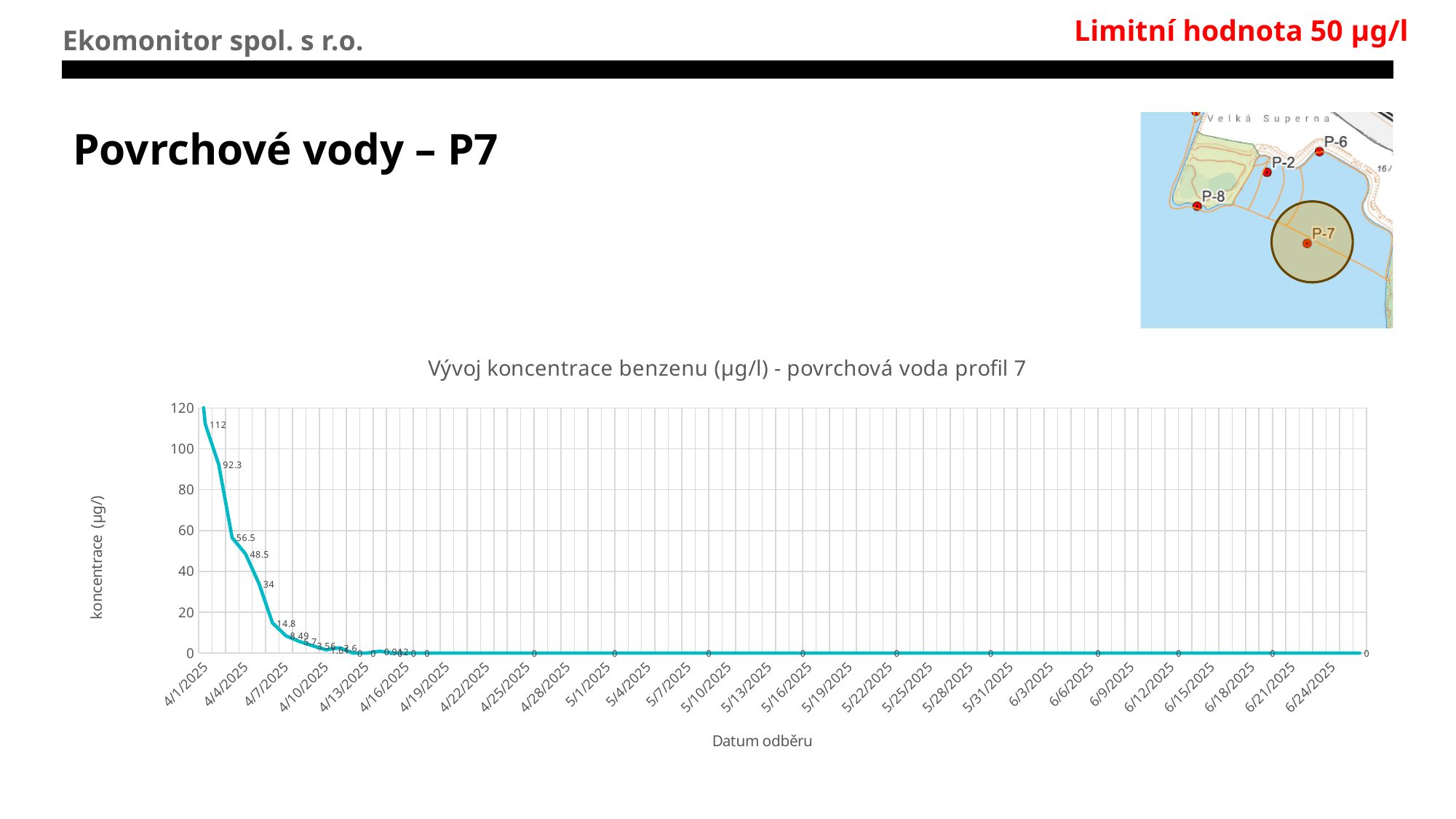
Do the values rise or fall along the x axis from 4/1/2025 onward? fall What is the difference between the labelled values 112 and 92.3? 19.7 Is the value at 5/1/2025 greater or less than 20? less What is the difference between the labelled values 56.5 and 48.5? 8 What is the title of the chart? Vývoj koncentrace benzenu (µg/l) - povrchová voda profil 7 Is the value at 4/1/2025 greater or less than 100? greater What value is labelled at the points from late April 2025 to the end of the series? 0 What is the highest labelled value on the chart? 112 What kind of chart is shown on the slide? line chart Is the value at 4/7/2025 greater or less than 40? less Which is larger, the value at 4/1/2025 or the value at 6/24/2025? 4/1/2025 What is the label of the y axis of the chart? koncentrace (µg/l)